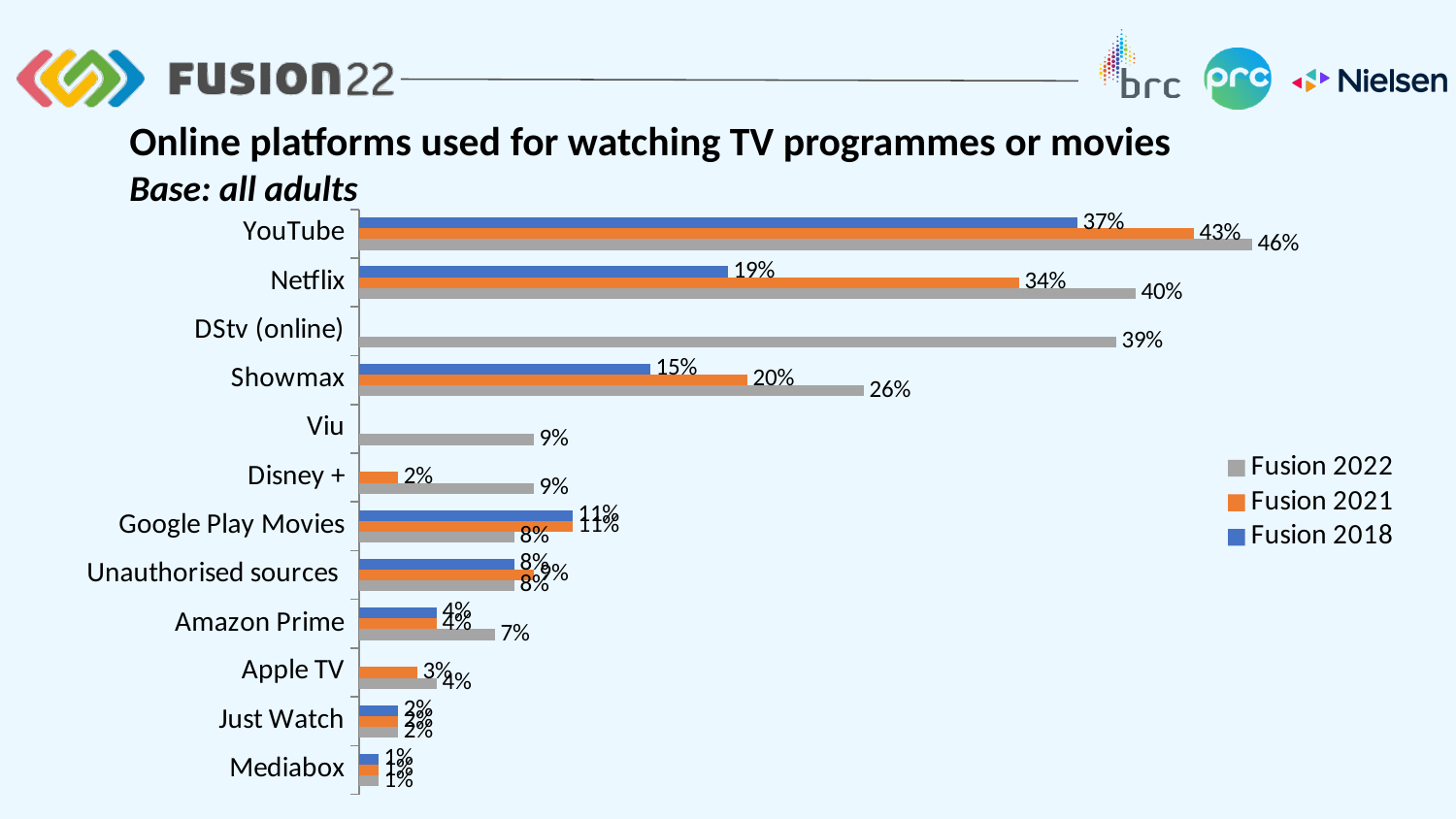
What is the Fusion 2022 value for Amazon Prime? 7% Which platform has the highest Fusion 2022 value? YouTube What is the Fusion 2022 value for YouTube? 46% What is the Fusion 2021 value for Showmax? 20% What is the difference between the Fusion 2022 and Fusion 2018 values for YouTube? 9 percentage points What is the Fusion 2022 value for DStv (online)? 39% Which is larger for Fusion 2022: Netflix or Showmax? Netflix Which series is shown in grey according to the legend? Fusion 2022 What is the Fusion 2018 value for Netflix? 19% How many series does the legend list? 3 What kind of chart is shown on the slide? Bar chart How many platforms are listed on the chart? 12